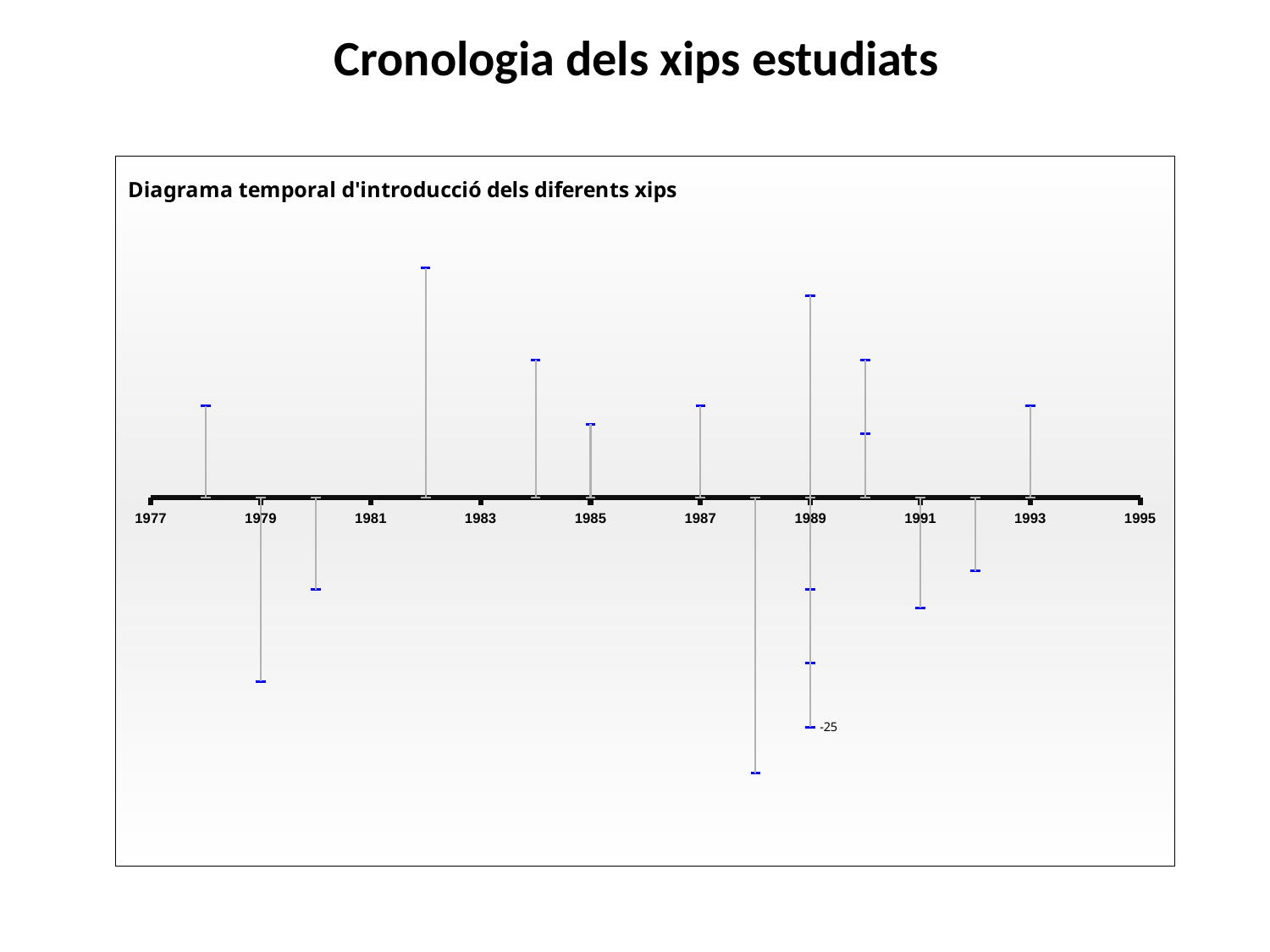
What is the first year label shown on the x axis of the chart? 1977 What is the title of the slide? Cronologia dels xips estudiats What is the title of the chart on the slide? Diagrama temporal d'introducció dels diferents xips Is the point at 1991 above or below the timeline axis? below Which year has the point that extends lowest below the timeline axis? 1988 Which year on the timeline has the most points plotted on it? 1989 Which year has the point that extends highest above the timeline axis? 1982 Is the point at 1982 above or below the timeline axis? above What is the last year label shown on the x axis of the chart? 1995 What is the only data label value printed on the chart? -25 At which year on the x axis does the point labelled -25 appear? 1989 How many year labels are printed along the x axis of the chart? 10